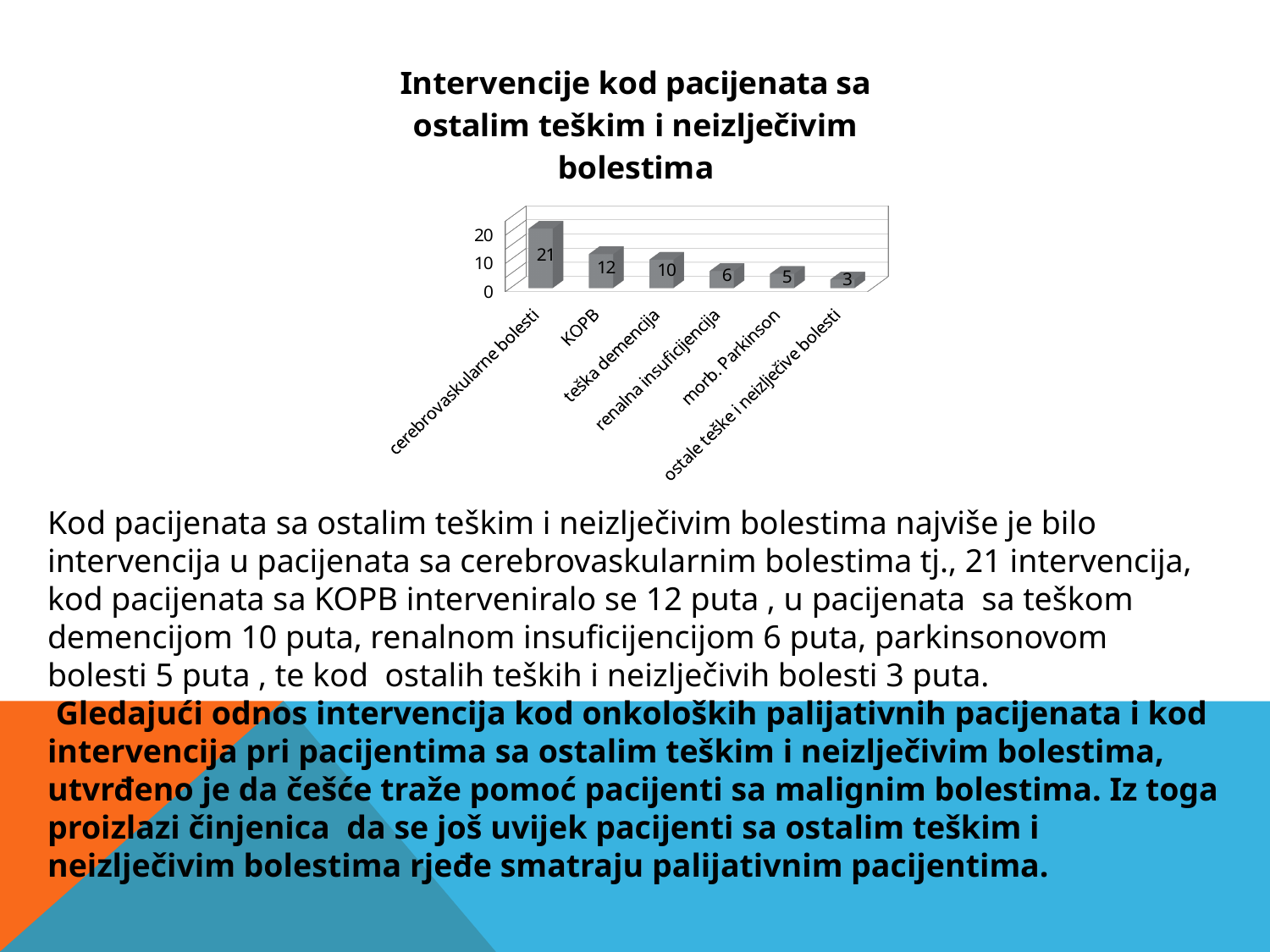
Which category has the highest value? cerebrovaskularne bolesti What kind of chart is shown on the slide? bar chart How many categories are shown in the chart? 6 Which is larger, the value for teška demencija or the value for renalna insuficijencija? teška demencija What is the value for KOPB? 12 Do the values rise or fall from left to right along the x axis? fall What is the difference between the values for cerebrovaskularne bolesti and KOPB? 9 What is the value for morb. Parkinson? 5 What is the value for renalna insuficijencija? 6 What is the value for cerebrovaskularne bolesti? 21 What is the value for teška demencija? 10 Which category has the lowest value? ostale teške i neizlječive bolesti